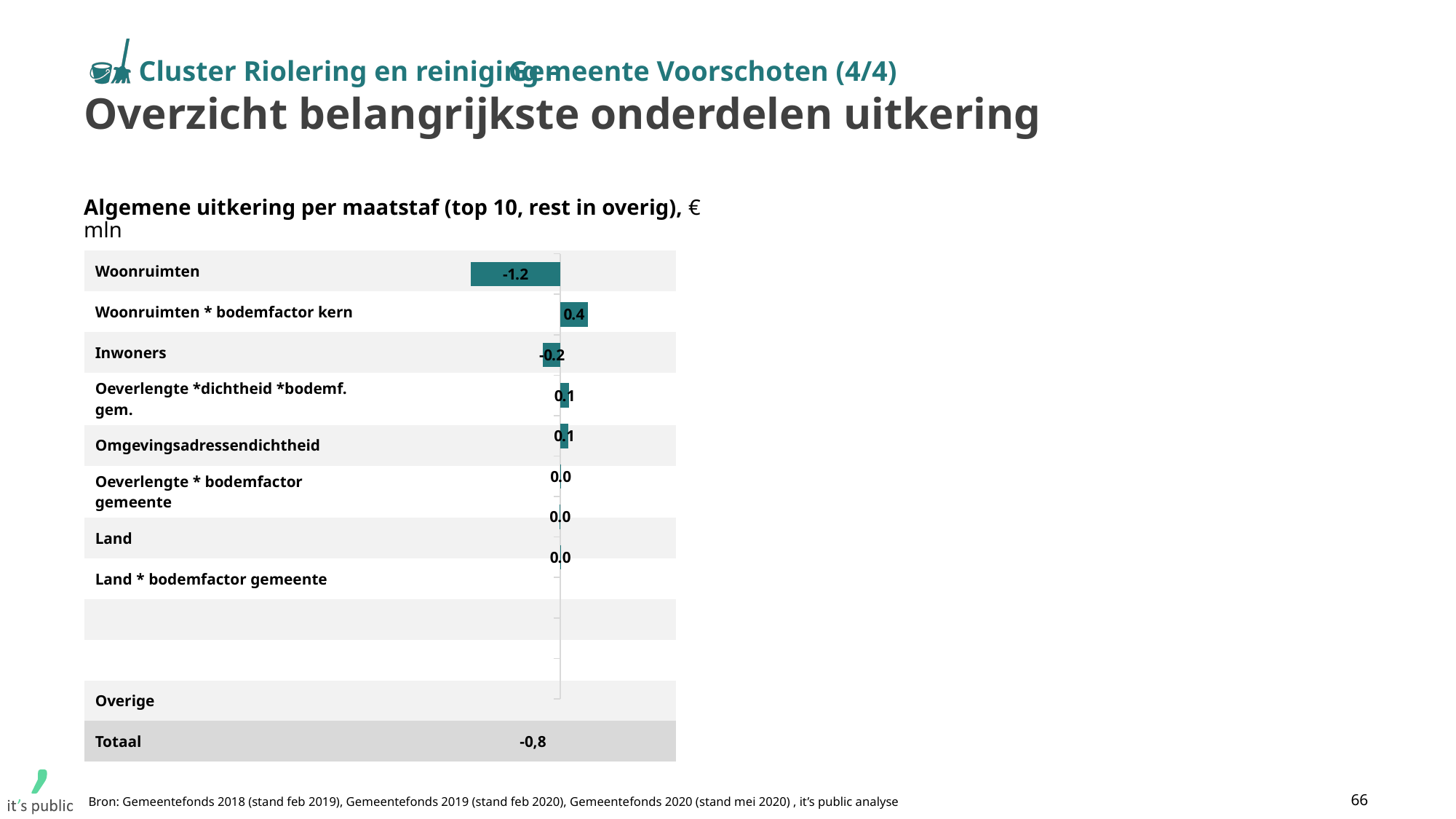
What is the title of the chart? Algemene uitkering per maatstaf (top 10, rest in overig), € mln What is the value for Woonruimten * bodemfactor kern? 0.4 Which category has the highest value? Woonruimten * bodemfactor kern What is the value for Omgevingsadressendichtheid? 0.1 Which category has the lowest (most negative) value? Woonruimten What is the Totaal value shown at the bottom of the chart? -0,8 Which is larger, the value for Woonruimten or the value for Inwoners? Inwoners What is the value for Inwoners? -0.2 What is the difference between the values for Woonruimten * bodemfactor kern and Inwoners? 0.6 What is the value for Land? 0.0 What kind of chart is shown on the slide? Bar chart What is the value for Woonruimten? -1.2